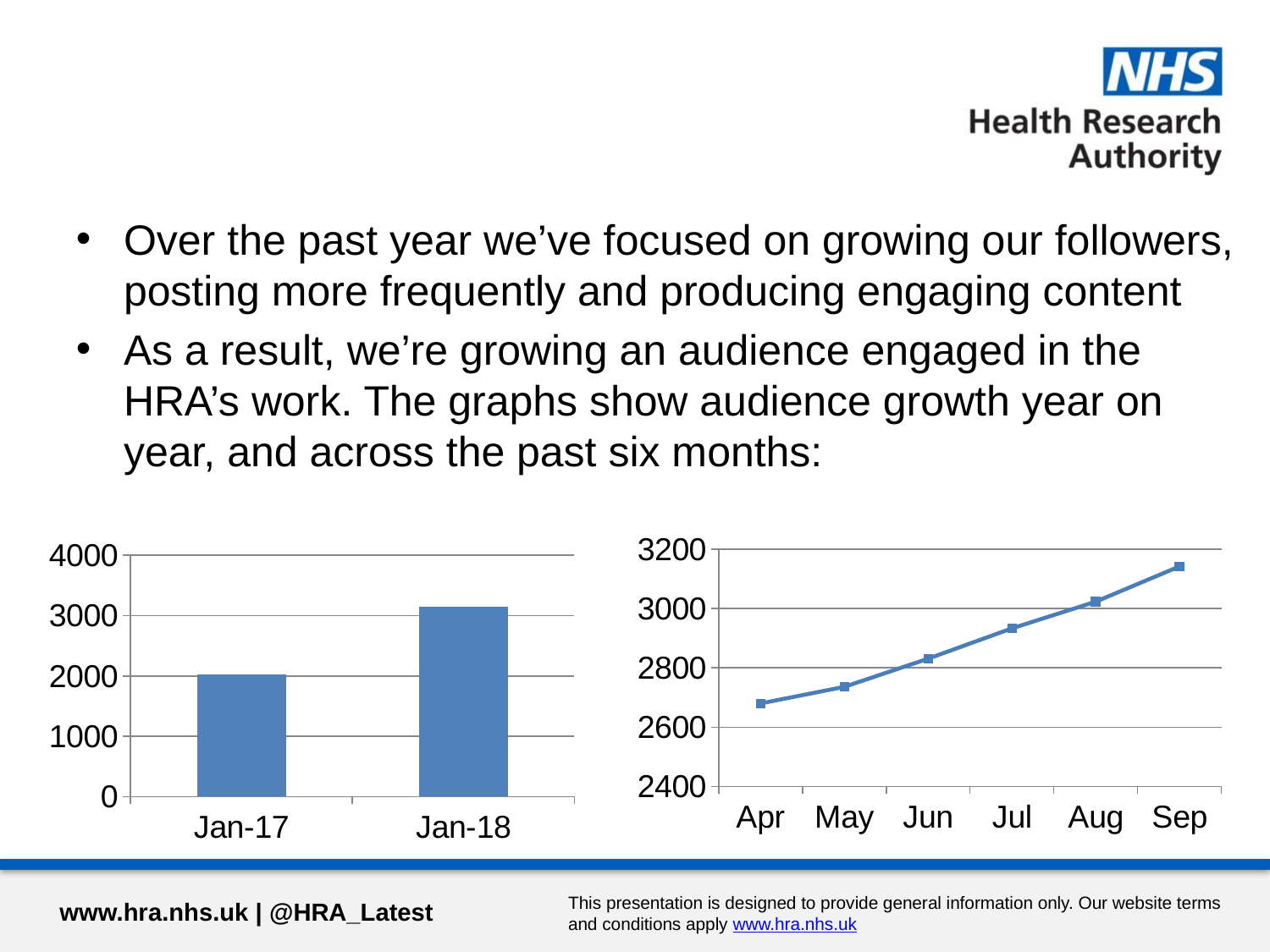
In the chart on the left, is the value for Jan-18 greater or less than 3000? greater What kind of chart is the chart on the left of the slide? bar chart In the chart on the right, which month has the highest value? Sep In the chart on the left, is the value for Jan-17 greater or less than 3000? less In the chart on the right, is the value for Sep greater or less than 3000? greater In the chart on the left, how many categories are shown on the x axis? 2 In the chart on the left, which category has the higher value, Jan-17 or Jan-18? Jan-18 In the chart on the right, do the values rise or fall from Apr to Sep? rise In the chart on the right, which month has the lowest value? Apr In the chart on the right, how many months are plotted along the x axis? 6 What kind of chart is the chart on the right of the slide? line chart